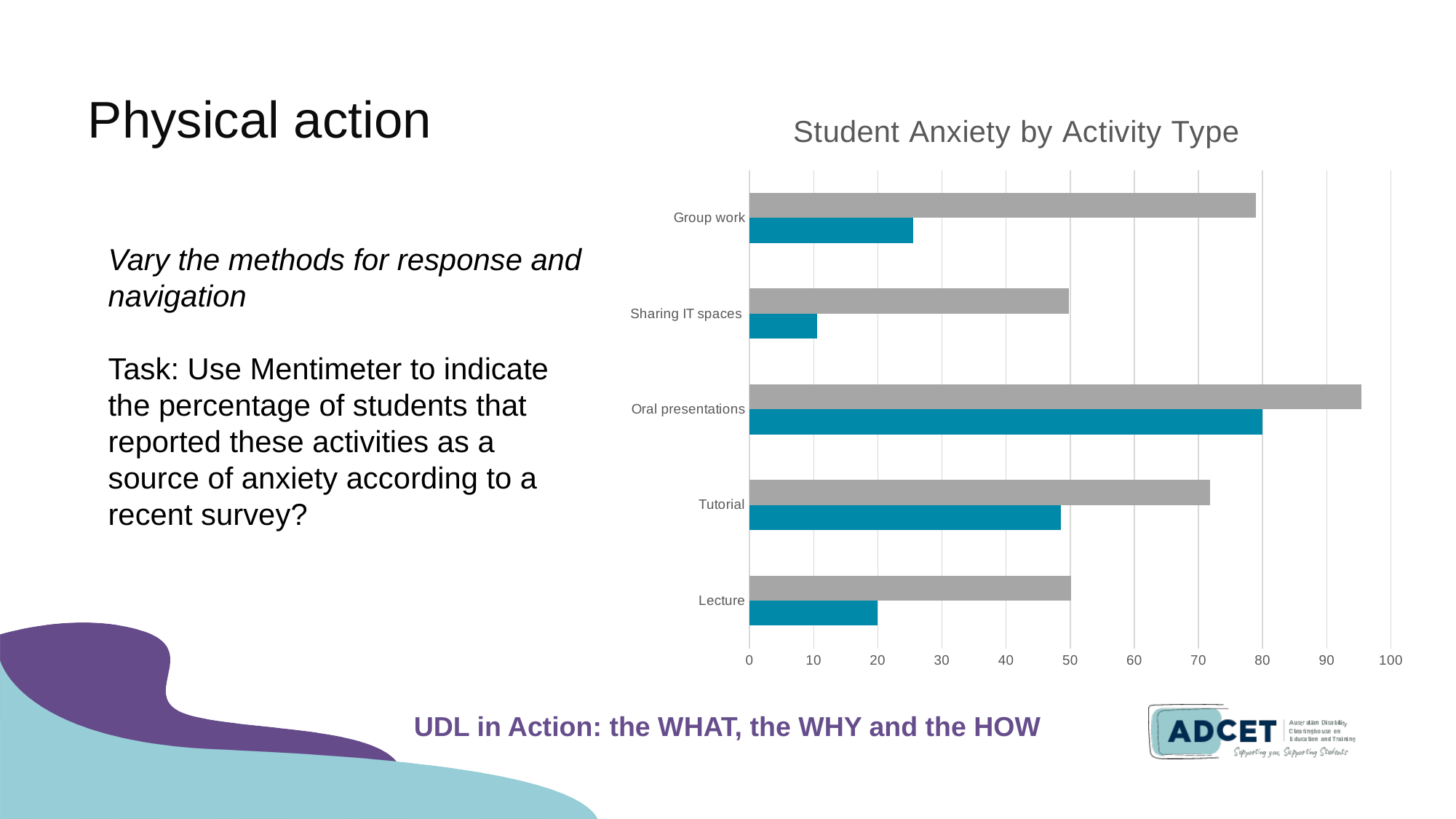
Which activity type has the longest grey bar? Oral presentations What kind of chart is shown on the slide? Bar chart Is the blue bar for Sharing IT spaces greater or less than 20? less What value does the blue bar for Lecture reach? 20 What is the title of the chart? Student Anxiety by Activity Type How many activity types are listed on the chart's vertical axis? 5 Is the grey bar for Group work greater or less than 70? greater Which has the longer grey bar, Group work or Tutorial? Group work Which activity type has the shortest blue bar? Sharing IT spaces Is the blue bar for Tutorial greater or less than 50? less What value does the blue bar for Oral presentations reach? 80 Which activity type has the longest blue bar? Oral presentations